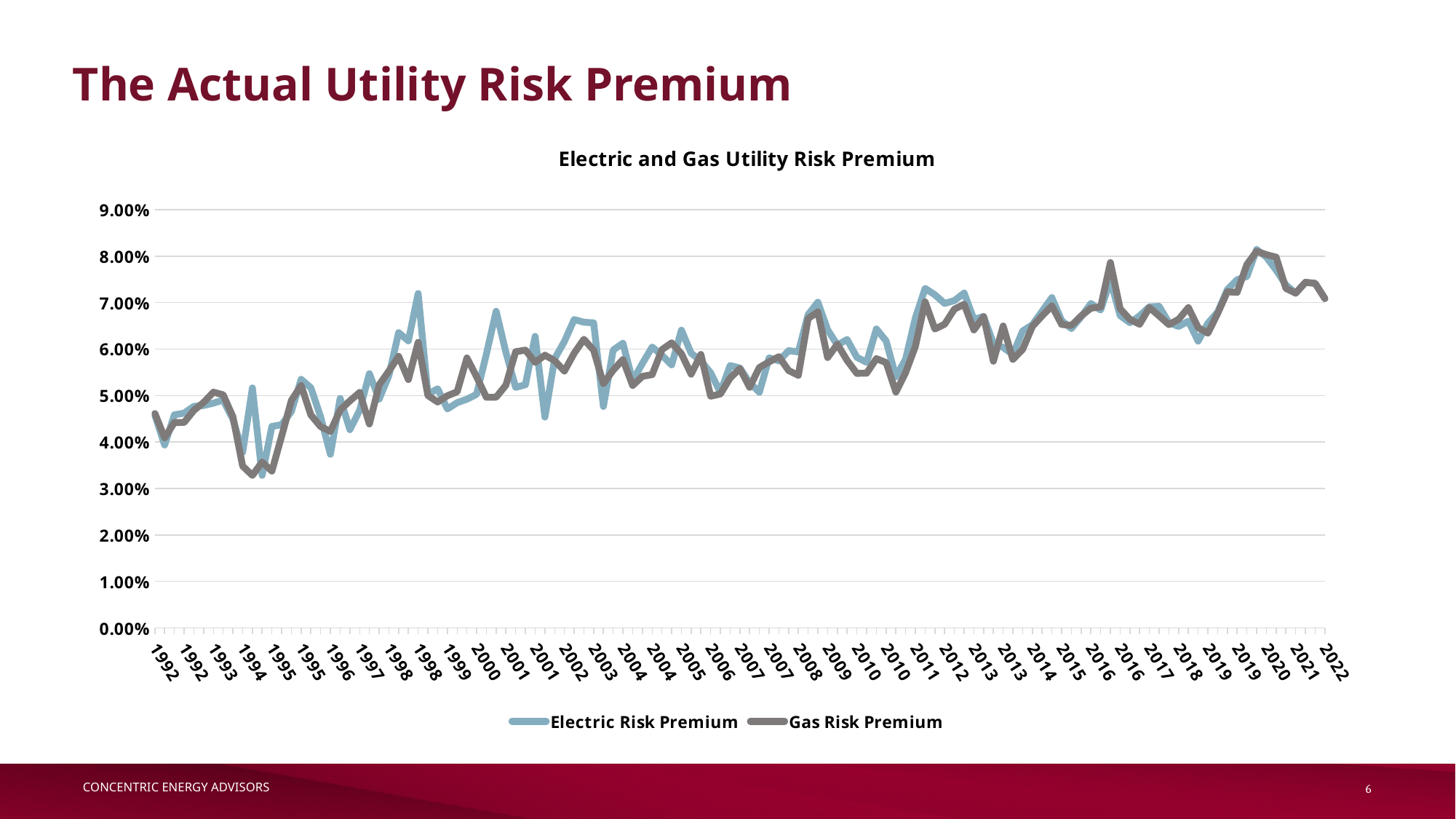
Overall, do the risk premium values rise or fall from 1992 to 2022? Rise What is the title of the chart? Electric and Gas Utility Risk Premium At the 1998 peak, which series is higher, Electric Risk Premium or Gas Risk Premium? Electric Risk Premium Is the Electric Risk Premium at the start of 1992 greater or less than 5.00%? less Which series is drawn in blue? Electric Risk Premium How many series does the legend list? 2 Is the peak of the Electric Risk Premium around 2019 greater or less than 7.00%? greater What kind of chart is shown on the slide? Line chart Is the Gas Risk Premium in 2022 greater or less than 6.00%? greater At the 2016 spike, which series is higher, Electric Risk Premium or Gas Risk Premium? Gas Risk Premium In which year does the Gas Risk Premium reach its lowest value? 1994